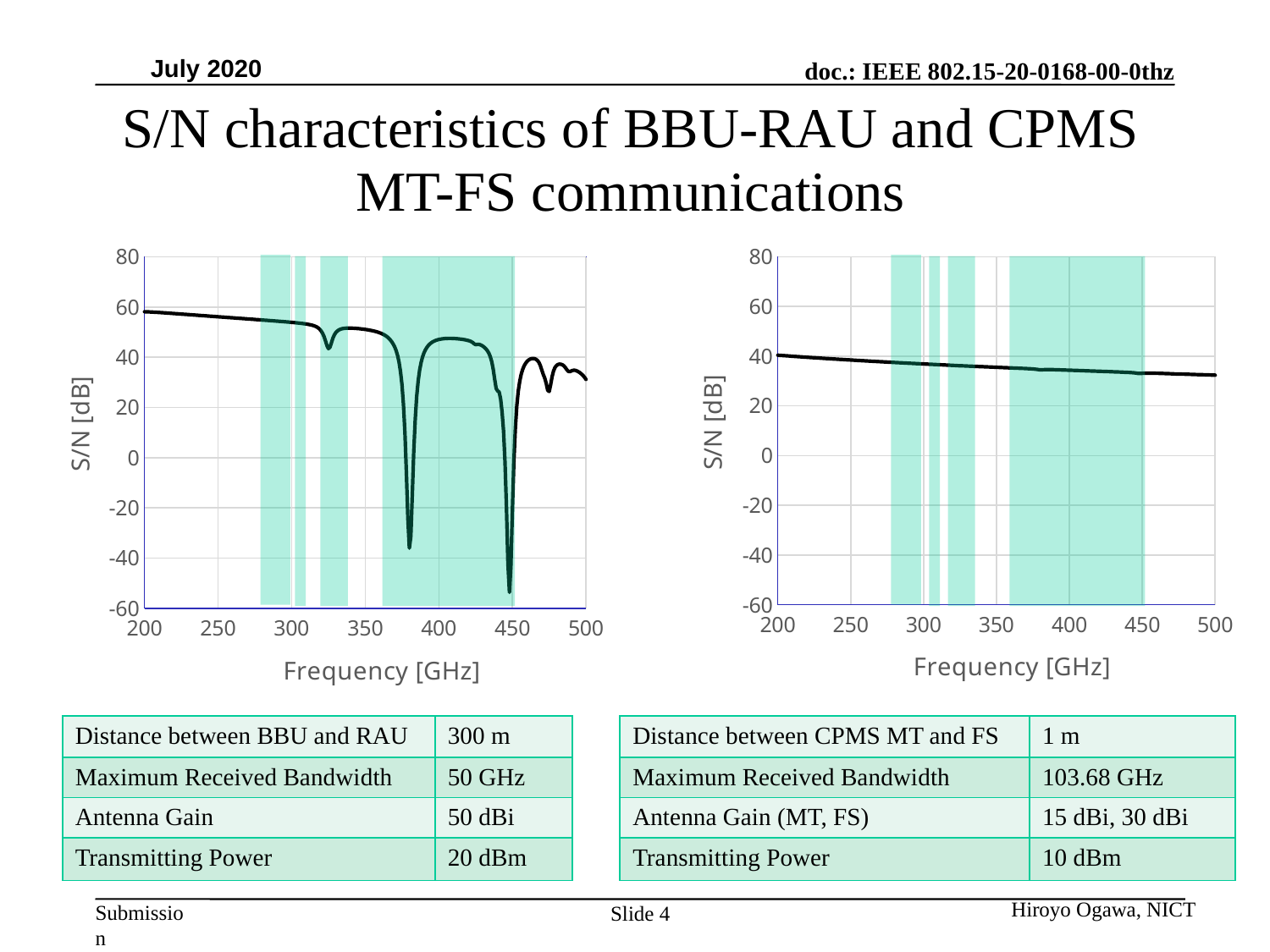
What kind of chart is the right chart on the slide? line chart In the left chart, which is larger, the S/N value at 300 GHz or at 500 GHz? 300 GHz In the left chart, is the S/N value at 300 GHz greater or less than 40 dB? greater What kind of chart is the left chart on the slide? line chart In the right chart, is the S/N value at 500 GHz greater or less than 40 dB? less What is the y-axis label of the right chart? S/N [dB] Which chart shows a higher S/N value at 200 GHz, the left chart or the right chart? the left chart In the right chart, is the S/N value at 200 GHz greater or less than 20 dB? greater What is the x-axis label of the left chart? Frequency [GHz] In the right chart, does the S/N value rise or fall as frequency increases from 200 to 500 GHz? fall